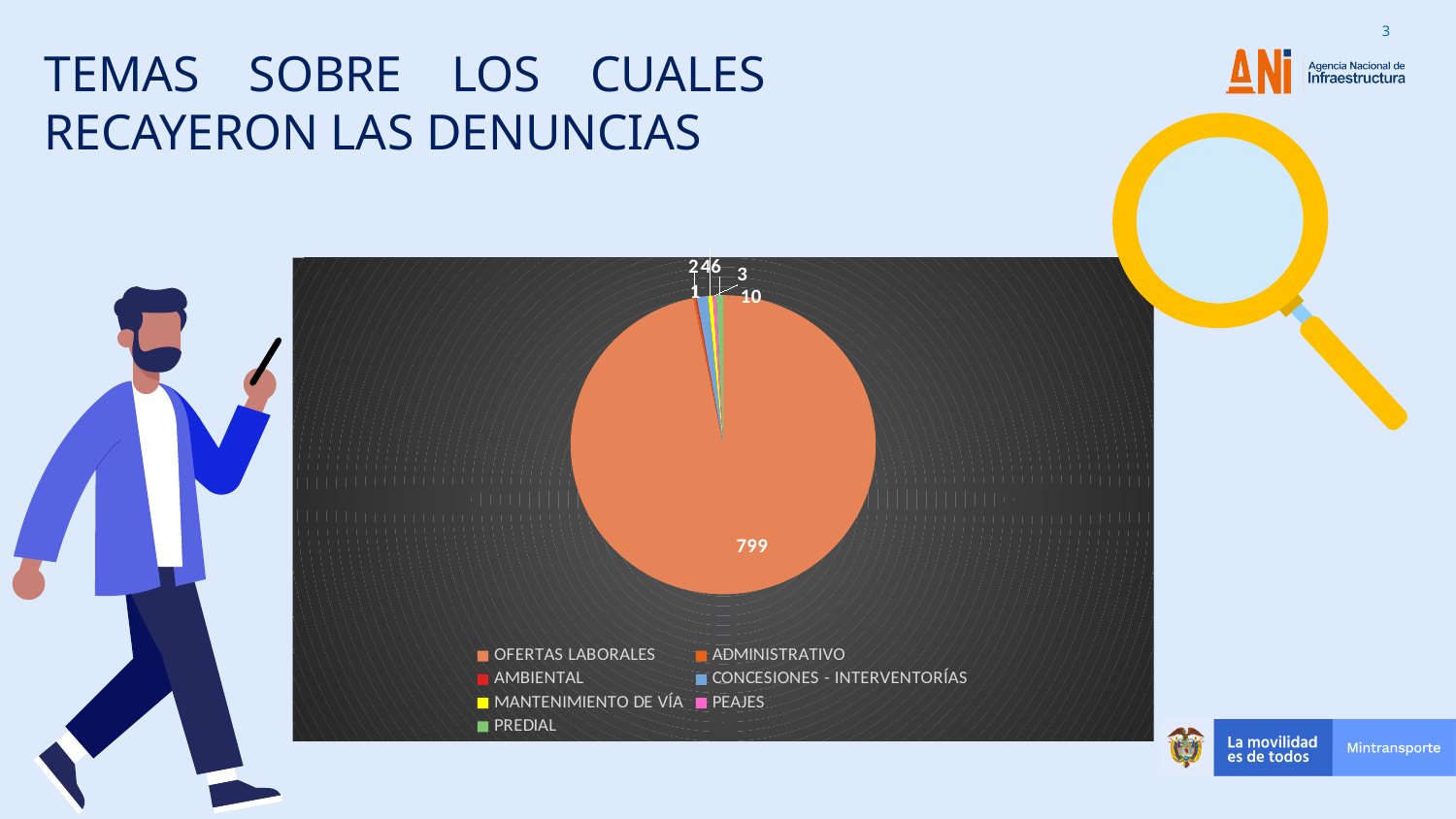
What colour is the slice for OFERTAS LABORALES in the pie chart? Orange What type of chart is shown on the slide? Pie chart How many data labels are printed on the pie chart? 7 Which category has the largest slice in the pie chart? OFERTAS LABORALES Which legend entry in the pie chart is shown in yellow? MANTENIMIENTO DE VÍA What is the smallest data label shown on the pie chart? 1 What is the value shown for OFERTAS LABORALES in the pie chart? 799 What is the largest data label shown on the pie chart? 799 Which is larger in the pie chart, the slice for OFERTAS LABORALES or the slice for PREDIAL? OFERTAS LABORALES How many categories does the legend of the pie chart list? 7 Which is larger in the pie chart, the slice for OFERTAS LABORALES or the slice for AMBIENTAL? OFERTAS LABORALES